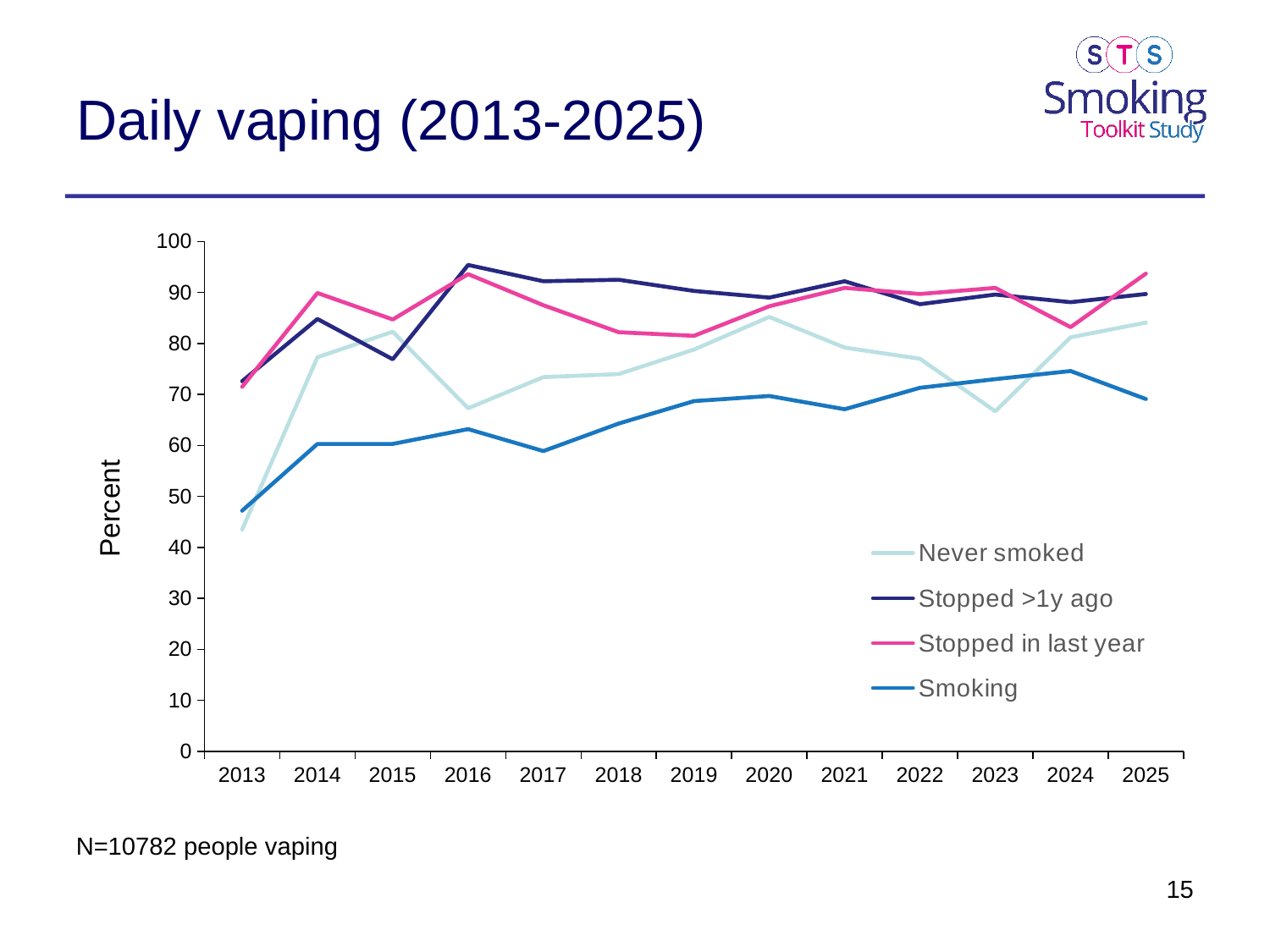
How many series does the legend list? 4 How many years are shown along the x axis? 13 In 2020, which is larger: the value for Never smoked or the value for Smoking? Never smoked Is the value for Stopped >1y ago in 2016 greater or less than 90? greater What kind of chart is shown on the slide? Line chart Does the Smoking line generally rise or fall from 2013 to 2024? Rise What is the label on the y axis? Percent Is the value for Never smoked in 2023 greater or less than 70? less In 2025, which is larger: the value for Stopped in last year or the value for Smoking? Stopped in last year Is the value for Smoking in 2013 greater or less than 50? less Which series has the highest value in 2025? Stopped in last year